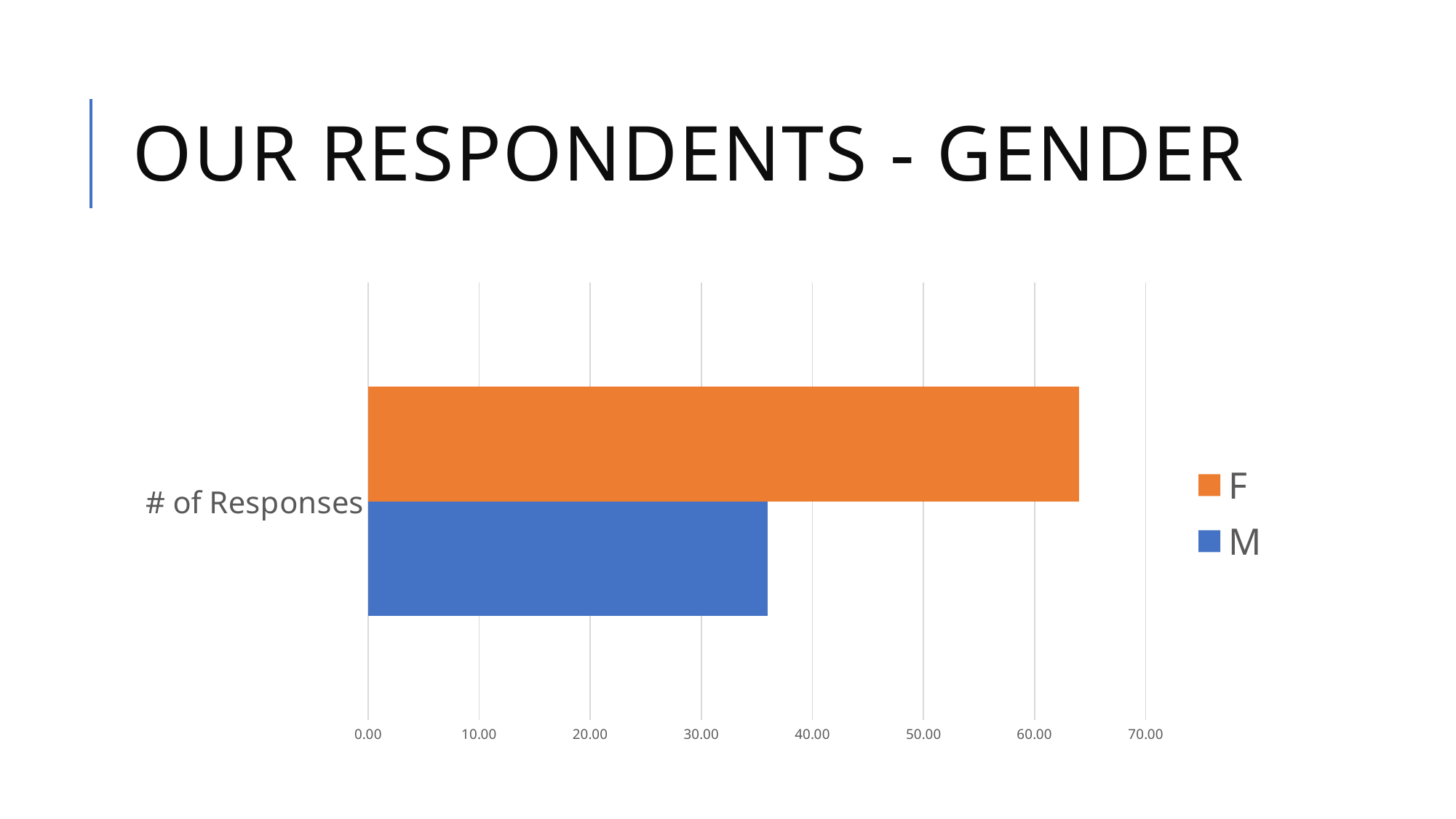
What is the label of the category on the vertical axis? # of Responses Which series has the smallest value for # of Responses? M How many categories are shown on the vertical axis? 1 What colour is the bar for the F series? orange Which series has the larger value for # of Responses, F or M? F How many series does the legend list? 2 Is the value for F greater or less than 60.00? greater What kind of chart is shown on the slide? bar chart Is the value for F greater or less than 70.00? less Is the value for M greater or less than 30.00? greater